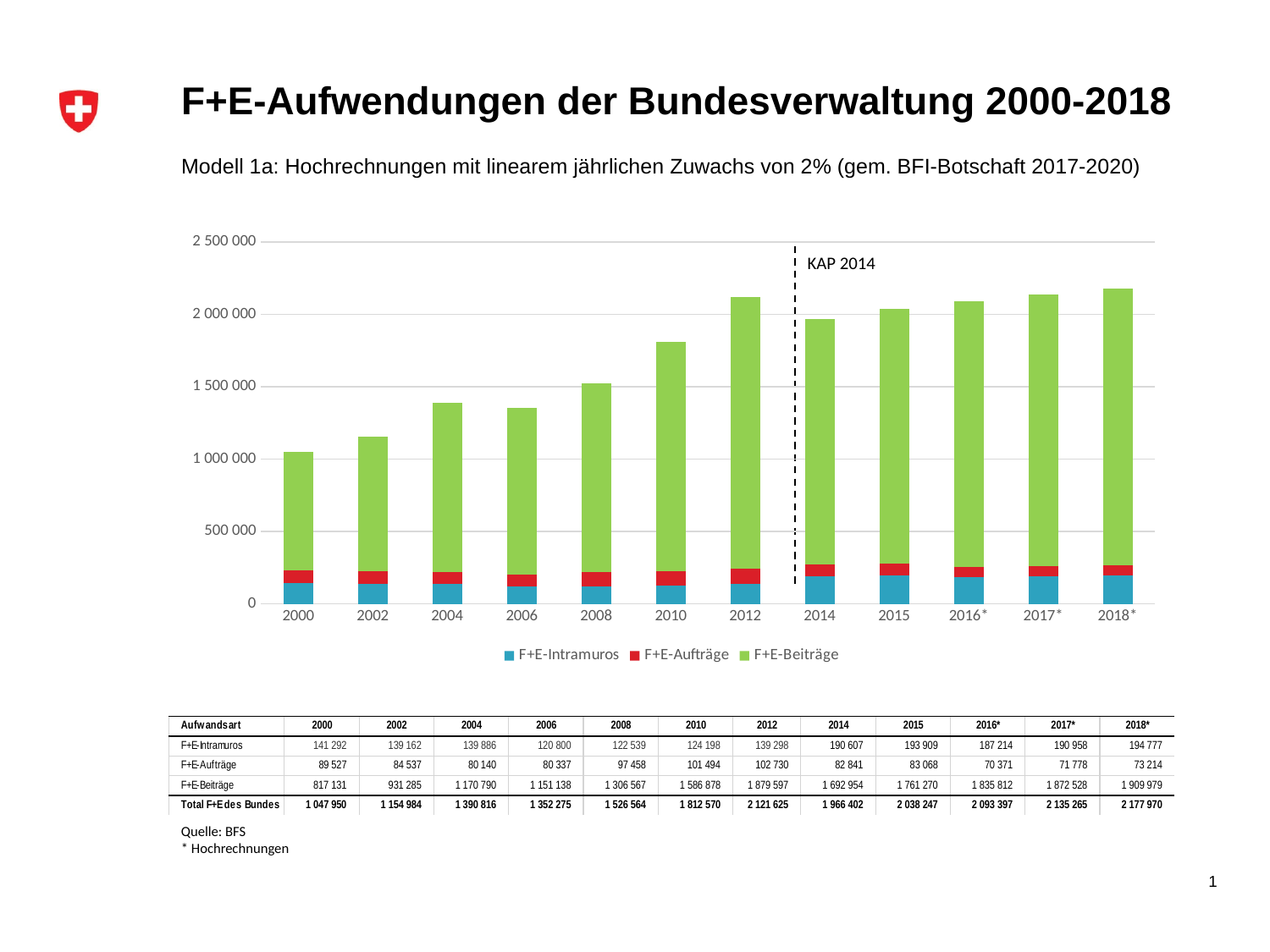
What is the difference between F+E-Intramuros in 2015 and in 2014? 3 302 How many years are shown along the x axis? 12 Which year has the highest total F+E expenditure? 2018* How many series does the legend list? 3 What label is written next to the dashed vertical line in the chart? KAP 2014 Is the total stacked bar for 2012 greater or less than 2 000 000? greater What is the value of F+E-Intramuros in 2014? 190 607 What is the total F+E expenditure (Total F+E des Bundes) for 2018*? 2 177 970 Which year has the larger value for F+E-Aufträge, 2010 or 2014? 2010 What is the value of F+E-Beiträge in 2012? 1 879 597 Which year has the lowest total F+E expenditure? 2000 What kind of chart is shown on the slide? Stacked bar chart